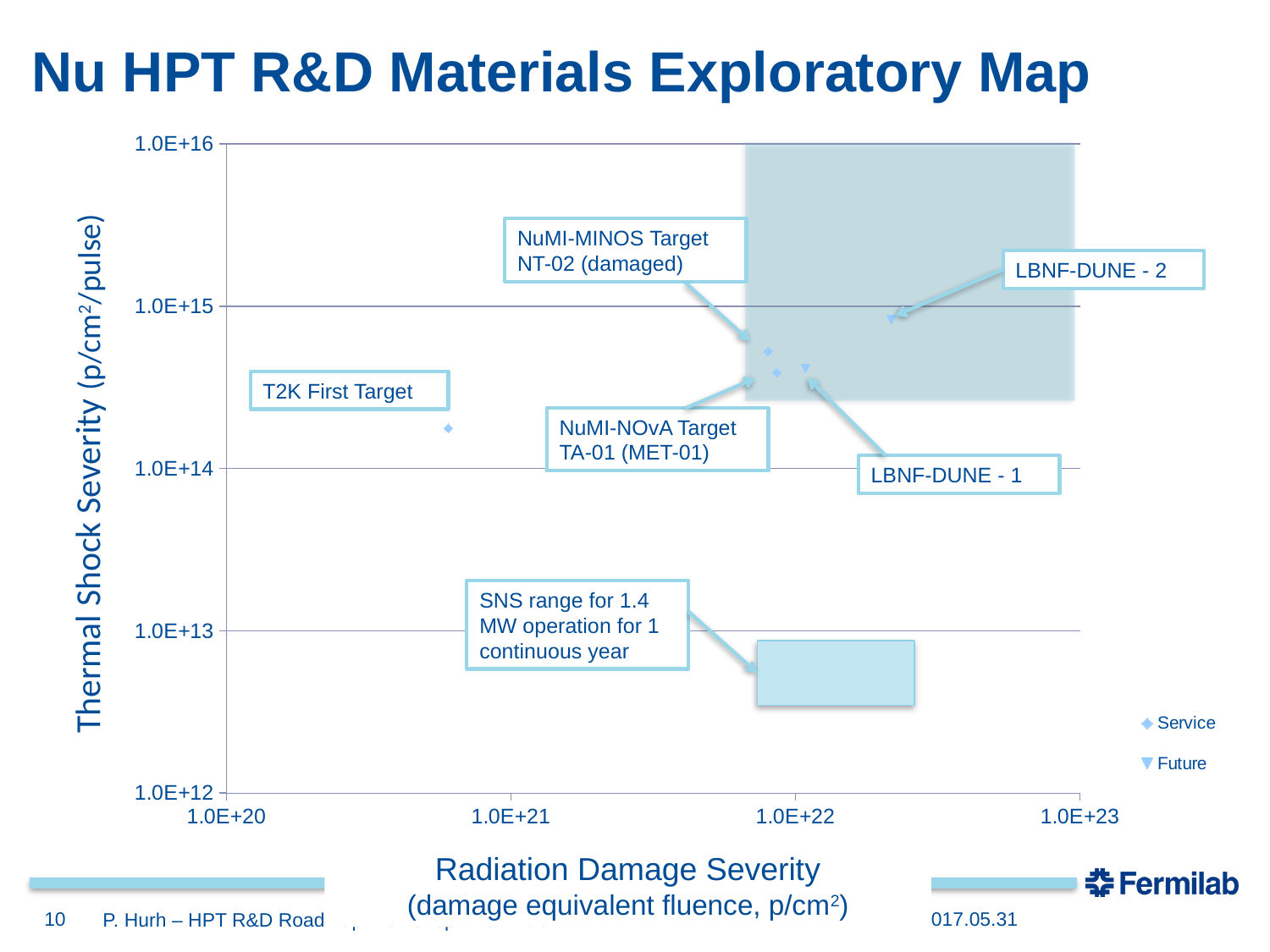
Is the Thermal Shock Severity for LBNF-DUNE - 2 greater or less than 1.0E+15? less What is the title of the chart's x axis? Radiation Damage Severity (damage equivalent fluence, p/cm2) How many labeled target points are plotted on the chart? 5 Which has the higher Thermal Shock Severity, T2K First Target or NuMI-MINOS Target NT-02? NuMI-MINOS Target NT-02 Is the Radiation Damage Severity for LBNF-DUNE - 2 greater or less than 1.0E+22? greater Which labeled point has the highest Thermal Shock Severity? LBNF-DUNE - 2 Is the Radiation Damage Severity for T2K First Target greater or less than 1.0E+21? less Which labeled point has the lowest Radiation Damage Severity? T2K First Target What are the two series named in the chart legend? Service and Future What kind of chart is shown on the slide? scatter chart Which labeled point has the lowest Thermal Shock Severity? T2K First Target How many series does the chart legend list? 2